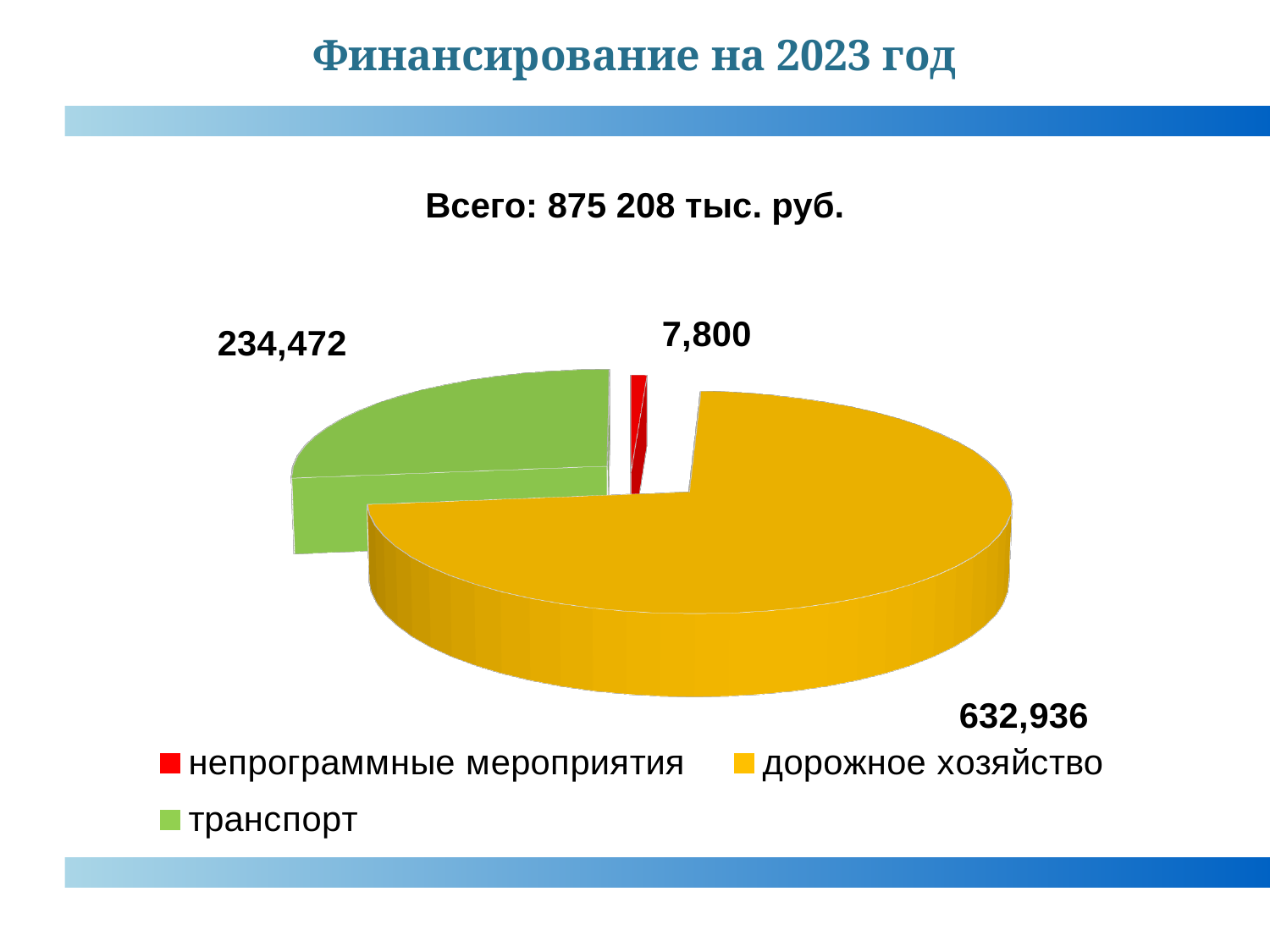
What is the value for транспорт? 234,472 What is the value for дорожное хозяйство? 632,936 What is the difference between the values for транспорт and непрограммные мероприятия? 226,672 What is the difference between the values for дорожное хозяйство and транспорт? 398,464 What total amount is stated above the chart? 875 208 тыс. руб. What is the value for непрограммные мероприятия? 7,800 Which is larger, the value for транспорт or the value for непрограммные мероприятия? транспорт What type of chart is shown on the slide? Pie chart What colour is the slice for транспорт? Green Which category has the smallest slice of the pie? непрограммные мероприятия Which category has the largest slice of the pie? дорожное хозяйство How many categories does the pie chart have? 3